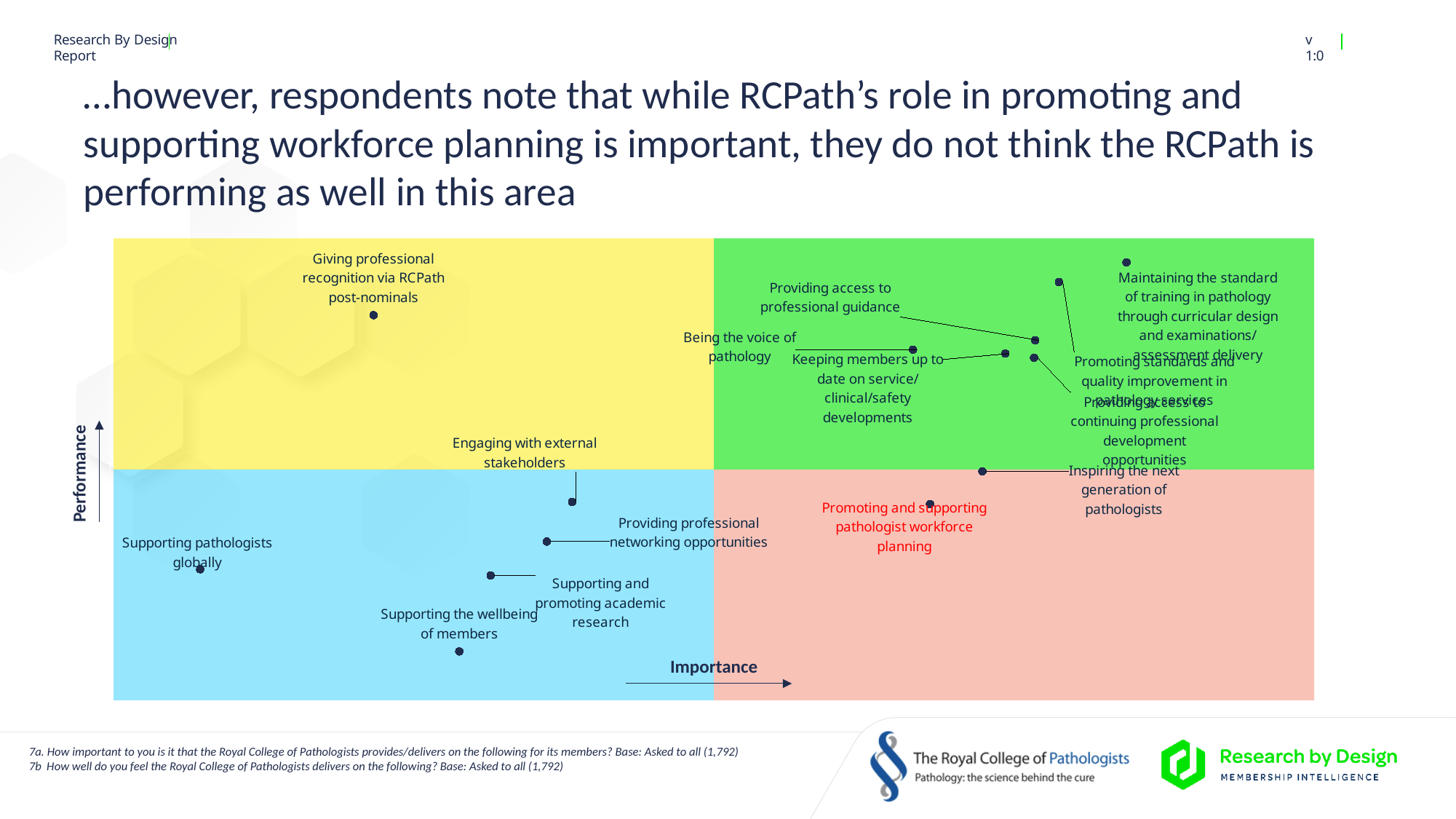
Which item is plotted with the lowest performance? Supporting the wellbeing of members In which quadrant of the chart does 'Giving professional recognition via RCPath post-nominals' fall? Top-left (low importance, high performance) How many items are plotted on the chart? 14 In which quadrant of the chart does 'Promoting and supporting pathologist workforce planning' fall? Bottom-right (high importance, low performance) What kind of chart is shown on the slide? Scatter chart Which item is plotted with the lowest importance? Supporting pathologists globally Which has higher performance: 'Engaging with external stakeholders' or 'Supporting the wellbeing of members'? Engaging with external stakeholders What does the horizontal axis of the chart represent? Importance What does the vertical axis of the chart represent? Performance Which is rated more important: 'Promoting and supporting pathologist workforce planning' or 'Supporting pathologists globally'? Promoting and supporting pathologist workforce planning Which item is plotted with the highest performance? Maintaining the standard of training in pathology through curricular design and examinations/assessment delivery Which item is plotted with the highest importance? Maintaining the standard of training in pathology through curricular design and examinations/assessment delivery